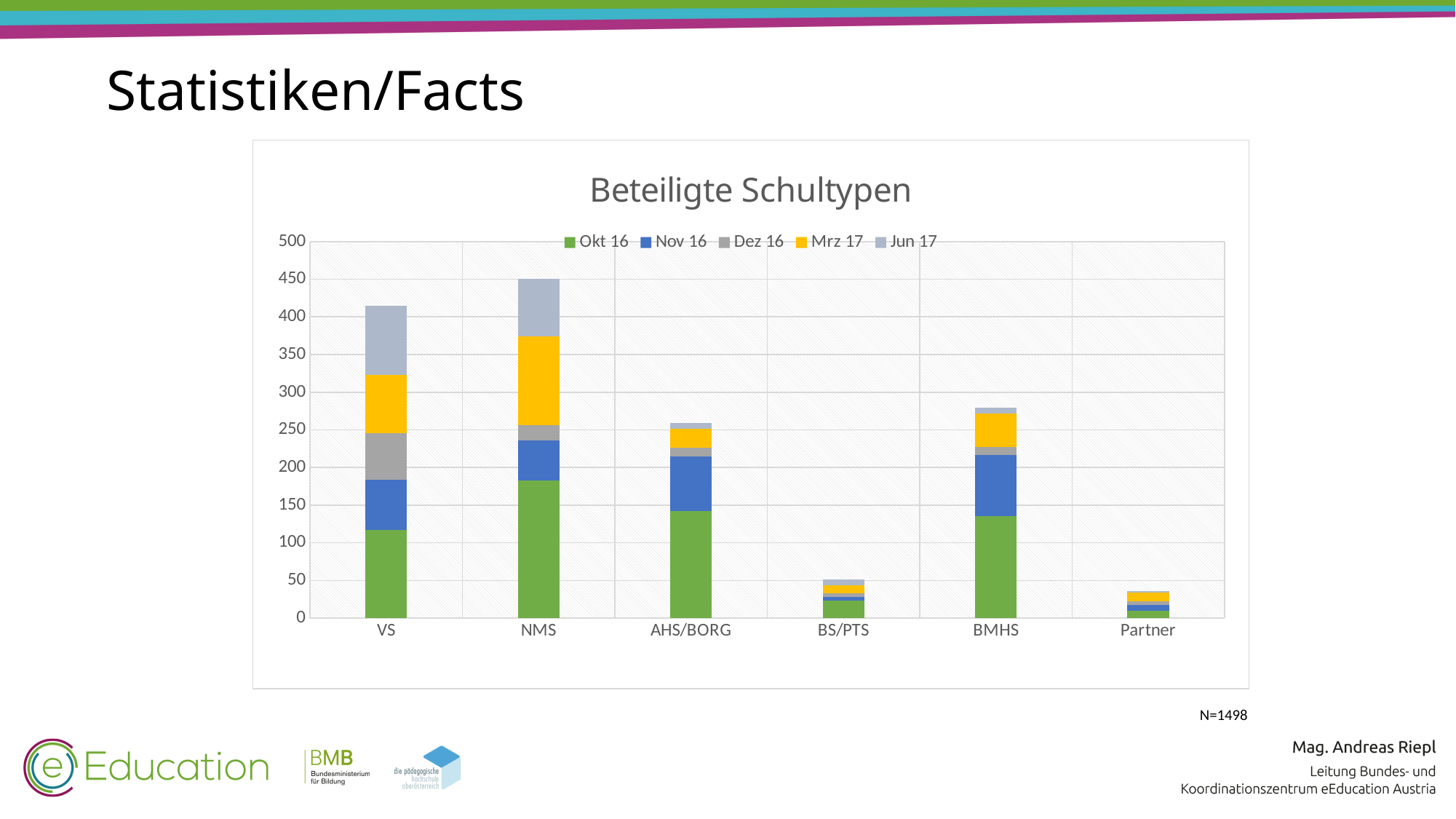
How many school-type categories are shown on the x axis? 6 What kind of chart is shown on the slide? stacked bar chart Is the total stacked value for BMHS greater or less than 300? less Is the Okt 16 value for NMS greater or less than 150? greater Which category has the tallest stacked bar overall? NMS Which category has the shortest stacked bar overall? Partner Is the total stacked value for BS/PTS greater or less than 100? less What is the title of the chart? Beteiligte Schultypen Which has the larger total stacked bar, VS or BMHS? VS Which series is shown in green in the legend? Okt 16 How many series does the legend list? 5